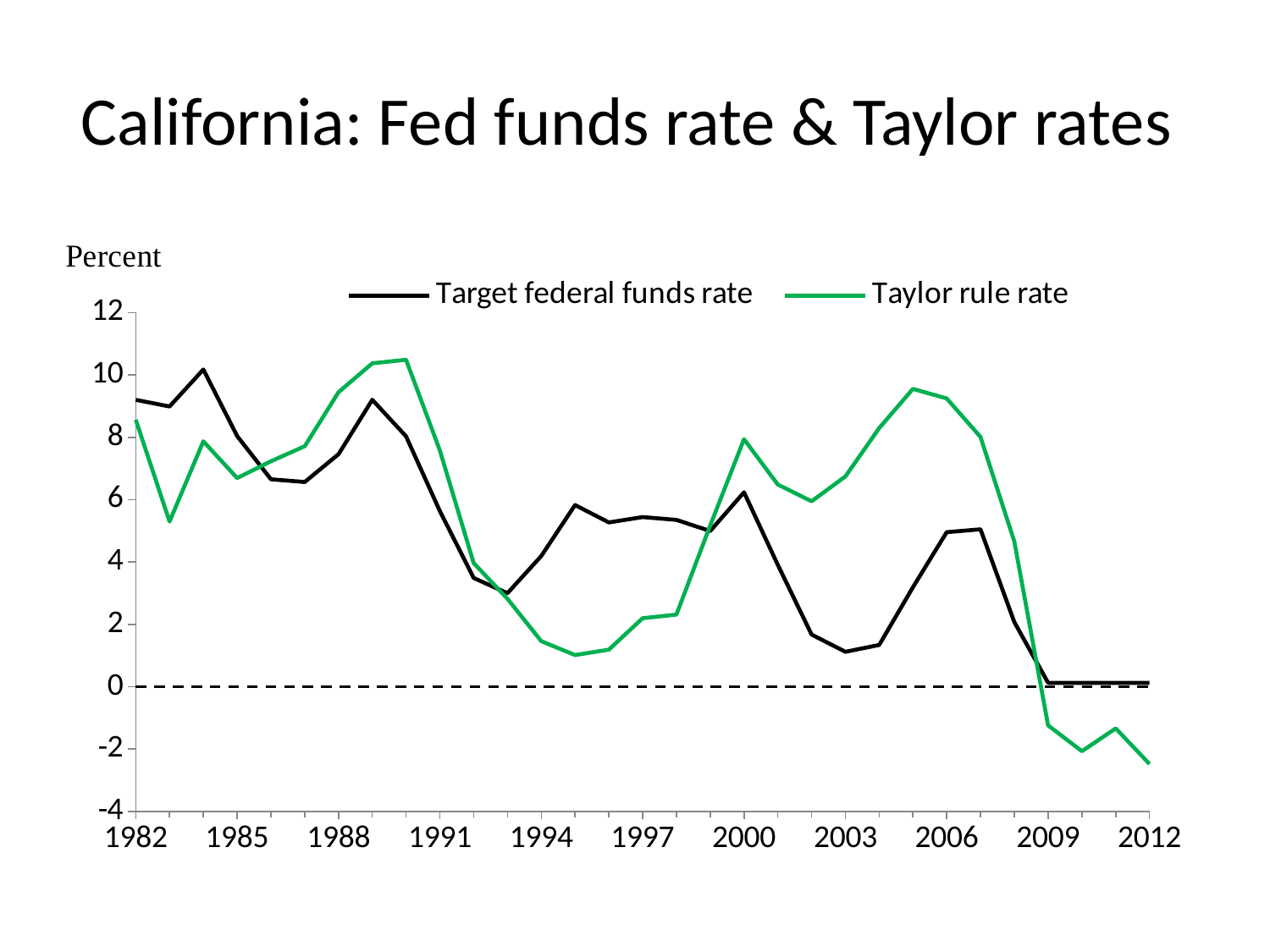
Does the Target federal funds rate rise or fall from 2007 to 2009? fall What colour is the Taylor rule rate line? green In 1995, which is higher: the Target federal funds rate or the Taylor rule rate? Target federal funds rate Is the Target federal funds rate in 2000 greater or less than 4? greater Is the Target federal funds rate in 2009 greater or less than 2? less In 2005, which is higher: the Target federal funds rate or the Taylor rule rate? Taylor rule rate Is the Taylor rule rate in 2005 greater or less than 8? greater How many series does the legend list? 2 What is the title of the chart? California: Fed funds rate & Taylor rates What kind of chart is shown on the slide? line chart